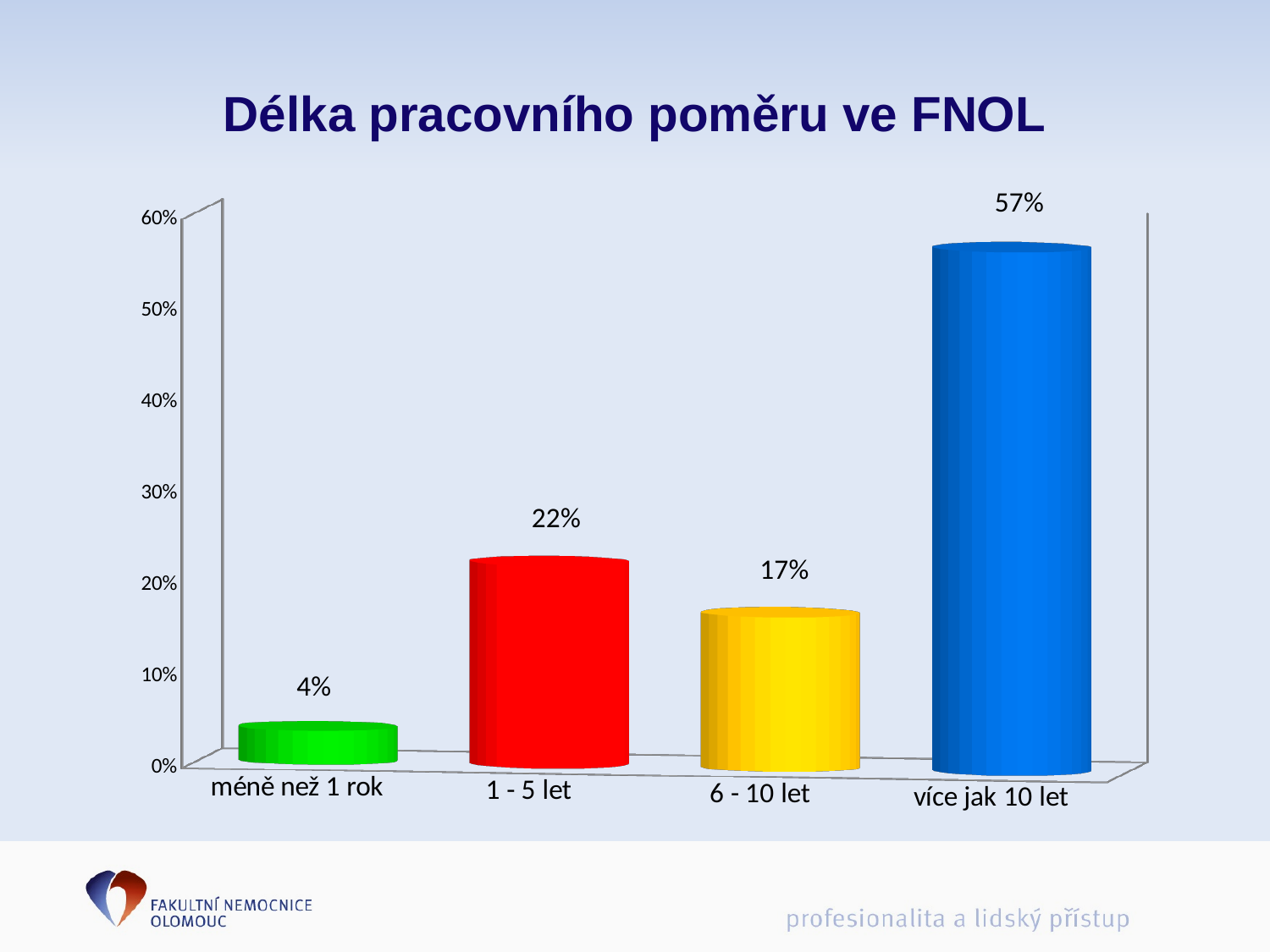
How many categories are shown on the chart? 4 What is the value for "méně než 1 rok"? 4% Which is larger, the value for "1 - 5 let" or the value for "6 - 10 let"? 1 - 5 let What kind of chart is shown on the slide? bar chart What is the difference between the values for "1 - 5 let" and "6 - 10 let"? 5% Which category has the highest value? více jak 10 let Which category has the lowest value? méně než 1 rok What is the value for "1 - 5 let"? 22% What is the difference between the values for "více jak 10 let" and "1 - 5 let"? 35% What is the value for "6 - 10 let"? 17% What is the value for "více jak 10 let"? 57% Is the value for "více jak 10 let" greater or less than 50%? greater